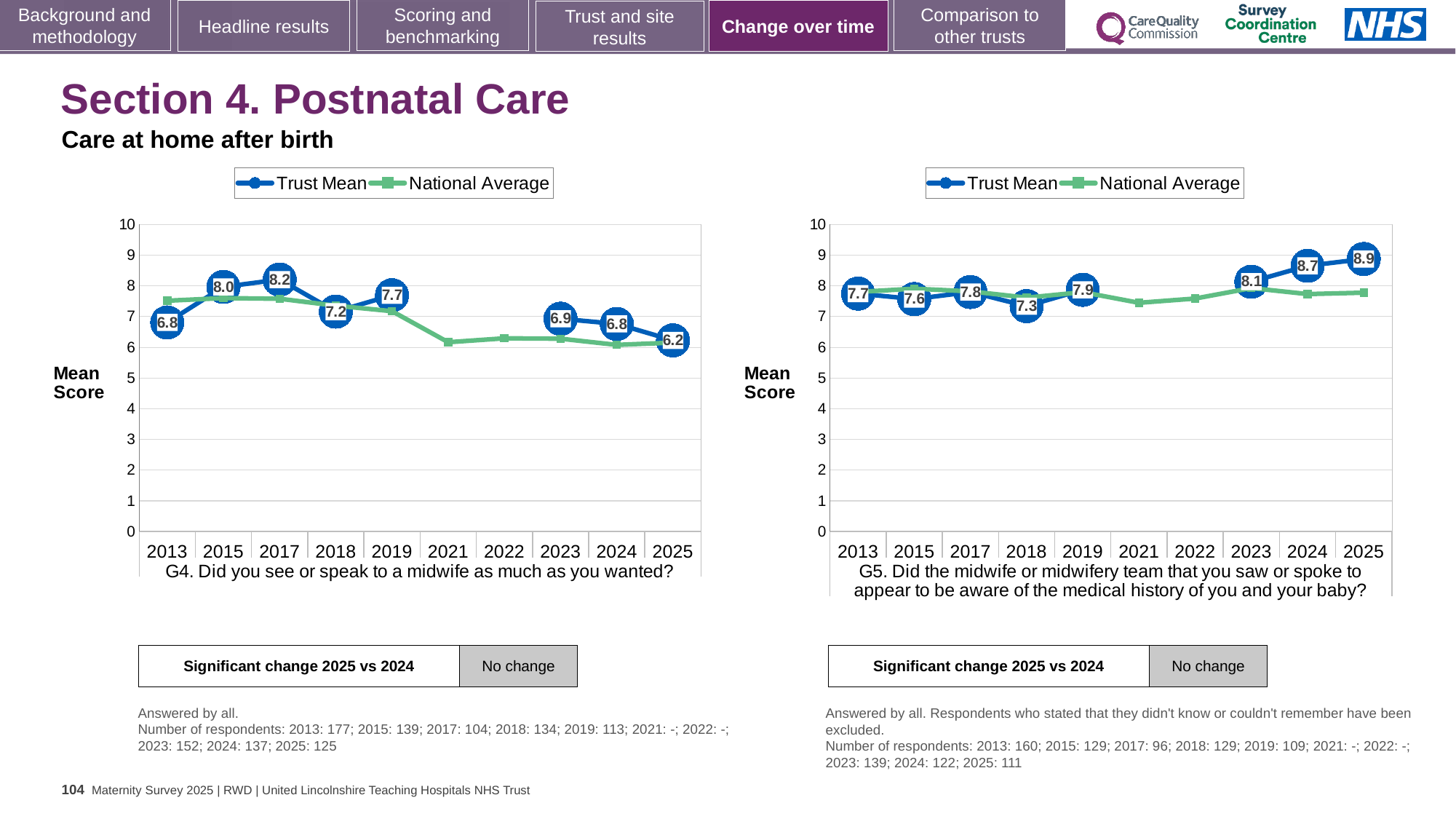
In the G5 chart (right), which year has the lowest Trust Mean? 2018 In the G4 chart (left), which year has the lowest Trust Mean? 2025 In the G4 chart (left), what is the Trust Mean for 2025? 6.2 What kind of chart is the G5 chart (right)? Line chart In the G5 chart (right), is the National Average for 2025 greater or less than 7? greater In the G4 chart (left), which year has the highest Trust Mean? 2017 In the G5 chart (right), which year has the highest Trust Mean? 2025 How many series does the legend of the G4 chart (left) list? 2 In the G5 chart (right), is the Trust Mean higher in 2019 or in 2018? 2019 In the G5 chart (right), what is the Trust Mean for 2024? 8.7 In the G4 chart (left), what is the difference between the Trust Mean in 2017 and in 2025? 2.0 In the G4 chart (left), what is the Trust Mean for 2017? 8.2